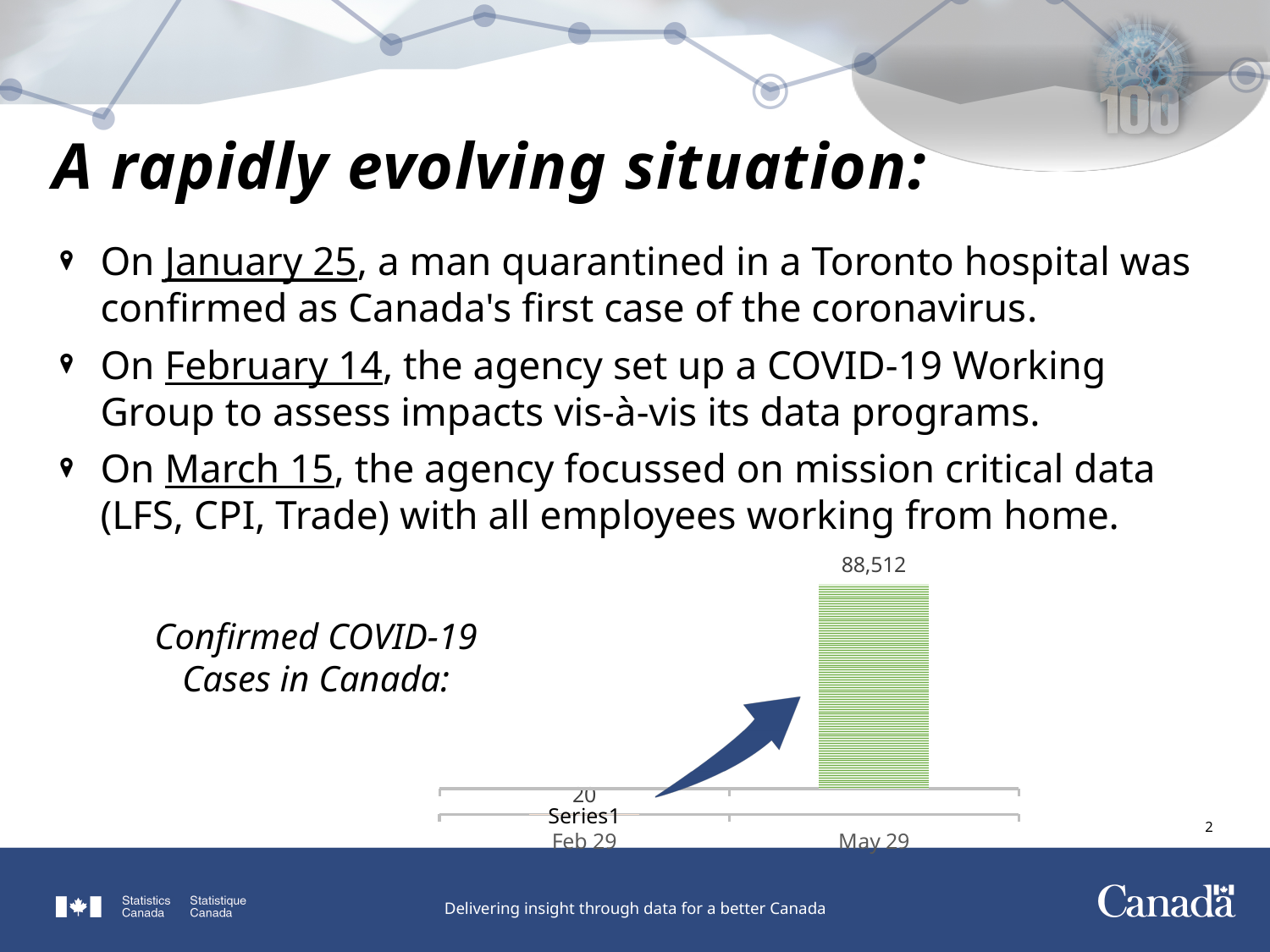
What kind of chart is used to show confirmed COVID-19 cases in Canada? bar chart What is the value for May 29 in the Confirmed COVID-19 Cases in Canada chart? 88,512 What is the title given for the chart on the slide? Confirmed COVID-19 Cases in Canada: How many dates (categories) are shown on the x axis of the chart? 2 Which date has the highest number of confirmed COVID-19 cases in the chart? May 29 Do the values rise or fall from Feb 29 to May 29 in the chart? rise Which date has the lowest number of confirmed COVID-19 cases in the chart? Feb 29 What is the value for Feb 29 in the Confirmed COVID-19 Cases in Canada chart? 20 What is the difference between the May 29 and Feb 29 values in the chart? 88,492 Is the value for May 29 larger or smaller than the value for Feb 29? larger